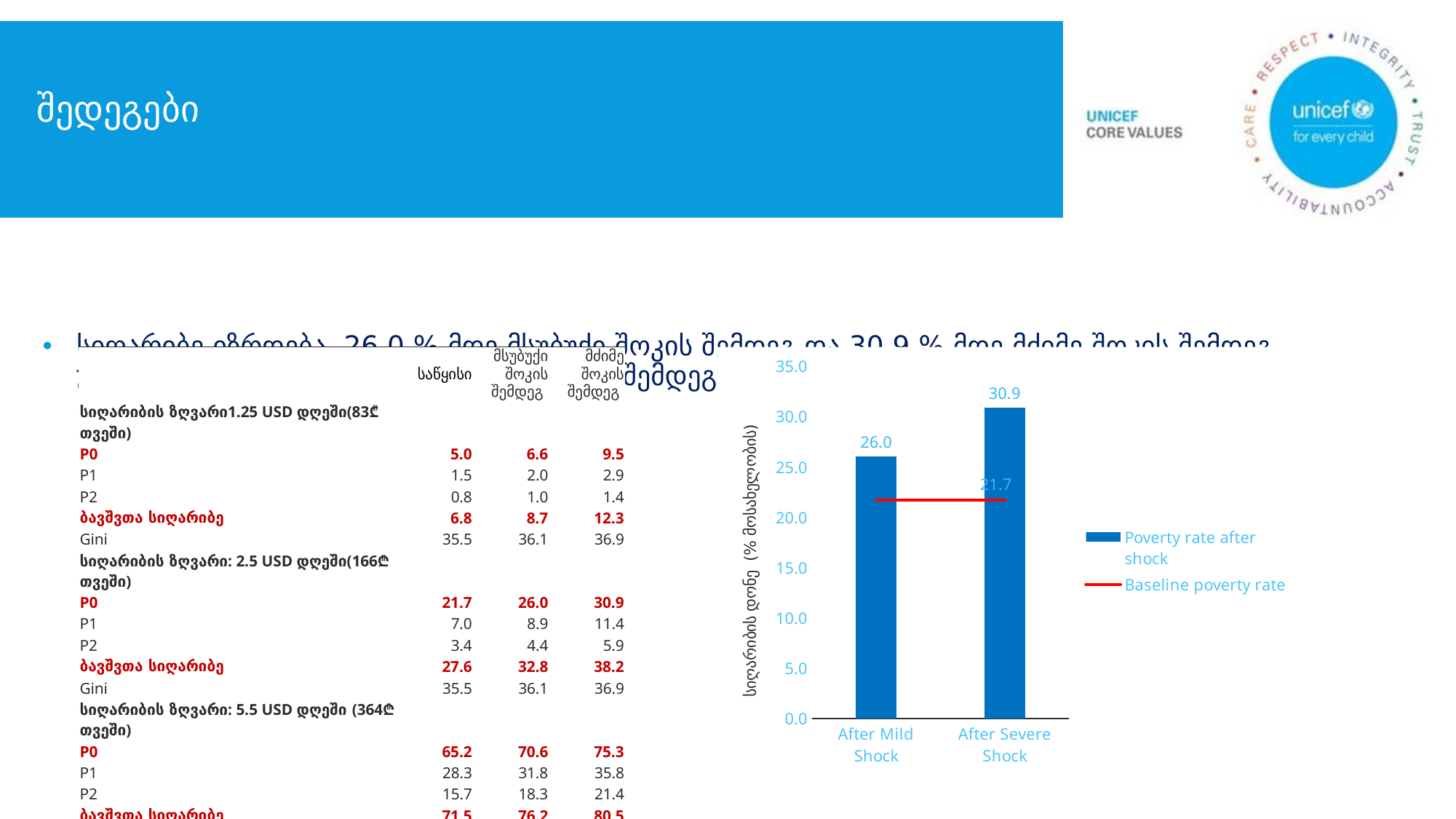
Which category has the lower poverty rate after shock? After Mild Shock What colour is the baseline poverty rate line in the chart? Red What value is shown for the baseline poverty rate line? 21.7 What is the difference between the poverty rate after shock for After Severe Shock and After Mild Shock? 4.9 What is the poverty rate after shock for After Severe Shock? 30.9 What is the poverty rate after shock for After Mild Shock? 26.0 How many series does the chart legend list? 2 What kind of chart is shown on the slide? Combination bar and line chart How many bars are plotted in the chart? 2 Is the poverty rate after shock for After Severe Shock greater or less than 30.0? greater Which category has the higher poverty rate after shock? After Severe Shock Is the poverty rate after shock for After Mild Shock greater or less than 25.0? greater